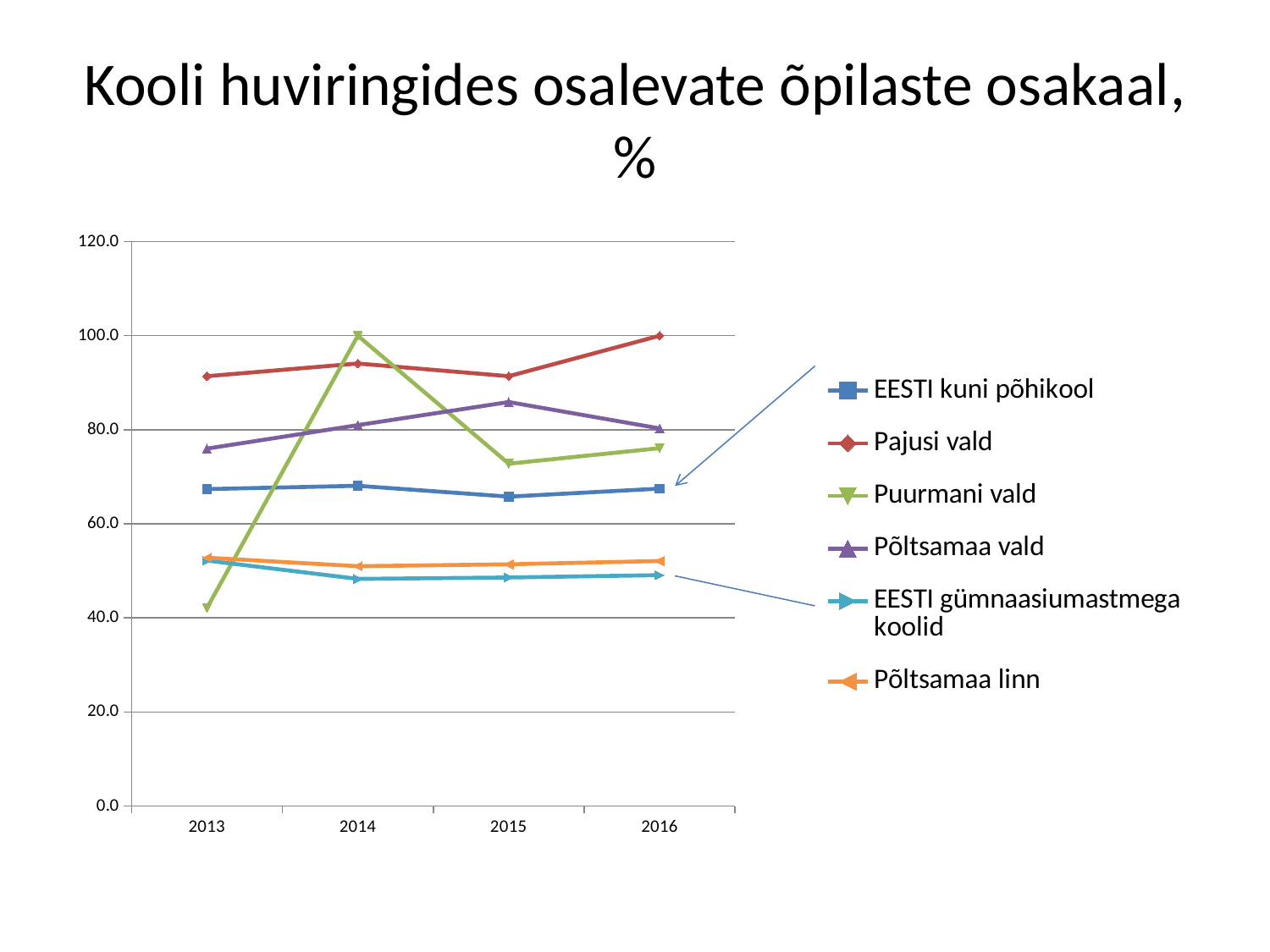
Is the value for EESTI gümnaasiumastmega koolid in 2014 greater or less than 60? less Which series has the highest value in 2016? Pajusi vald Which series has the lowest value in 2013? Puurmani vald What is the value for Pajusi vald in 2016? 100.0 How many years are shown on the x axis? 4 In 2015, which is larger: Põltsamaa vald or EESTI kuni põhikool? Põltsamaa vald Is the value for Puurmani vald in 2013 greater or less than 60? less What kind of chart is shown on the slide? line chart What is the value for Puurmani vald in 2014? 100.0 Is the value for Pajusi vald in 2013 greater or less than 80? greater Does the value for Puurmani vald rise or fall from 2014 to 2015? fall How many series does the legend list? 6